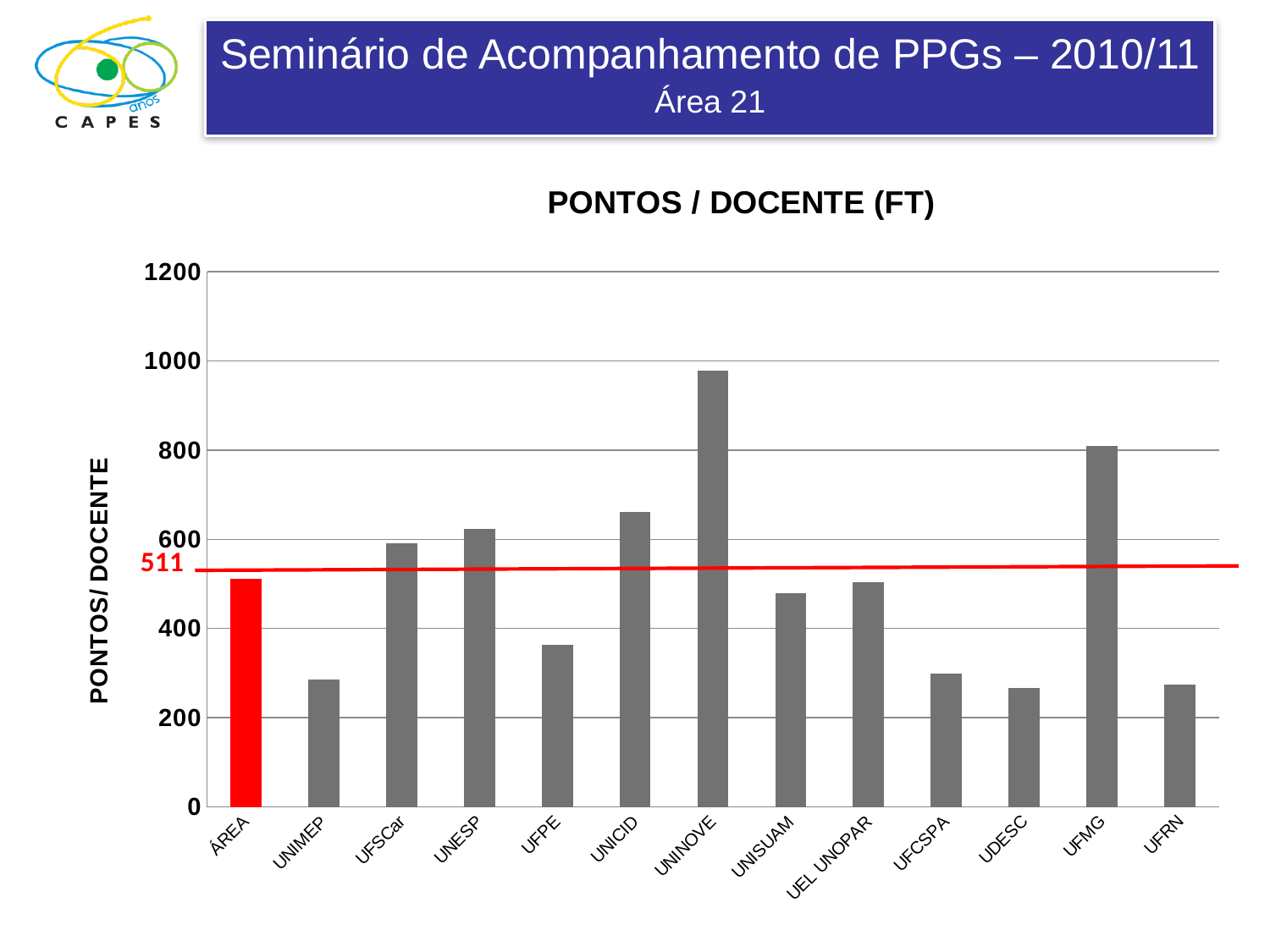
Is the value for UNICID greater or less than 600? greater What value is labelled on the red horizontal line in the chart? 511 Is the value for UNIMEP greater or less than 400? less How many categories are shown on the x axis of the chart? 13 Which category has the highest value in the chart? UNINOVE What kind of chart is shown on the slide? bar chart Is the value for UNISUAM greater or less than 600? less Which has the larger value, UNICID or UFPE? UNICID Which category's bar is coloured red in the chart? ÁREA Which has the larger value, UNINOVE or UFMG? UNINOVE